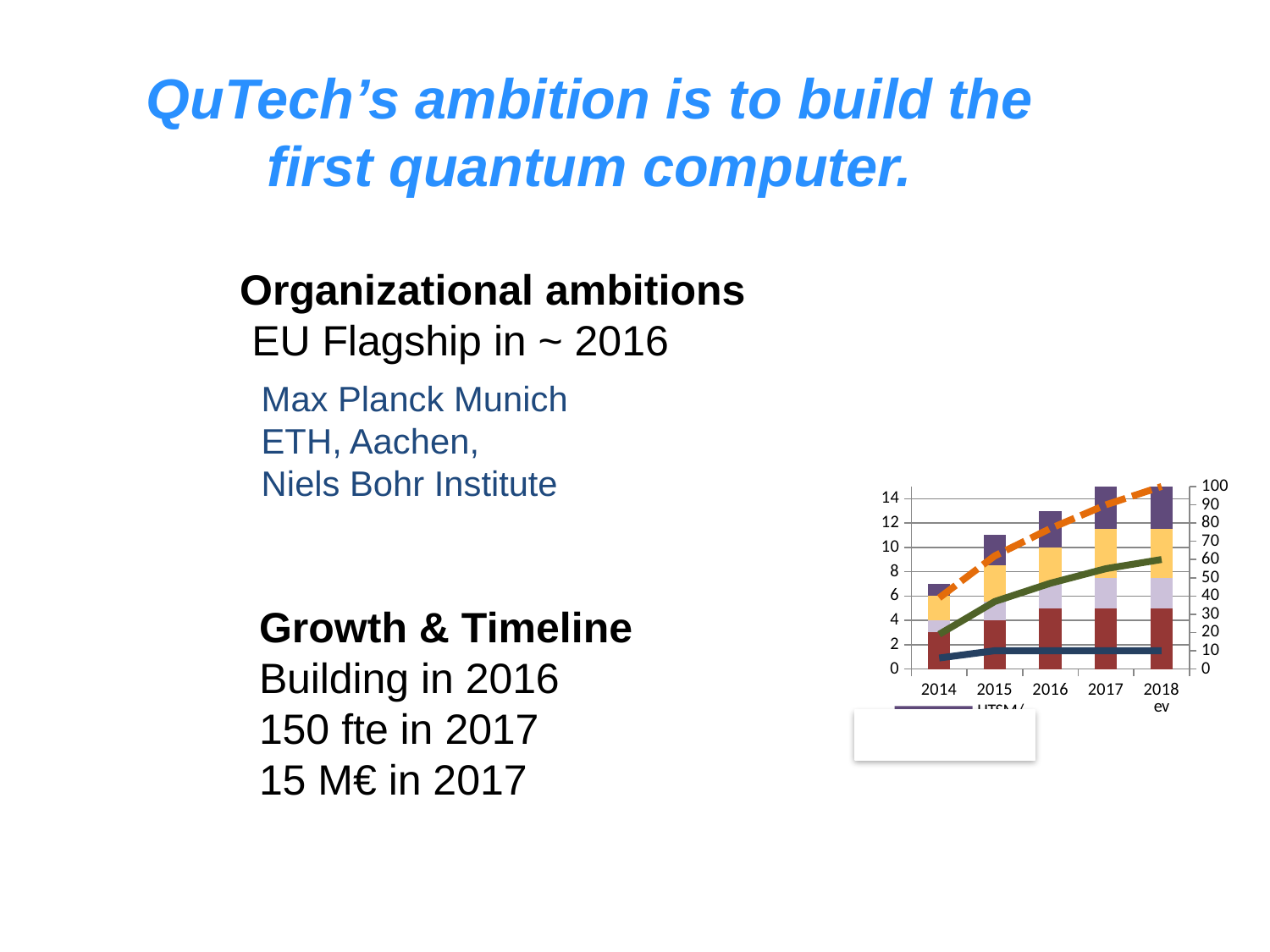
Is the stacked bar total for 2016 greater or less than 12 on the left axis? greater How many years are shown on the x axis of the chart? 5 What is the highest tick value on the right-hand axis of the chart? 100 Is the stacked bar total for 2014 greater or less than 6 on the left axis? greater What is the highest tick value on the left-hand axis of the chart? 14 Does the orange dashed line rise or fall from 2014 to 2018? Rise Which year has the larger stacked bar total, 2014 or 2016? 2016 Which year has the lowest stacked bar total in the chart? 2014 Do the stacked bar totals rise or fall from 2014 to 2018? Rise Is the stacked bar total for 2015 greater or less than 10 on the left axis? greater What kind of chart is shown on the slide? A stacked bar chart with line series